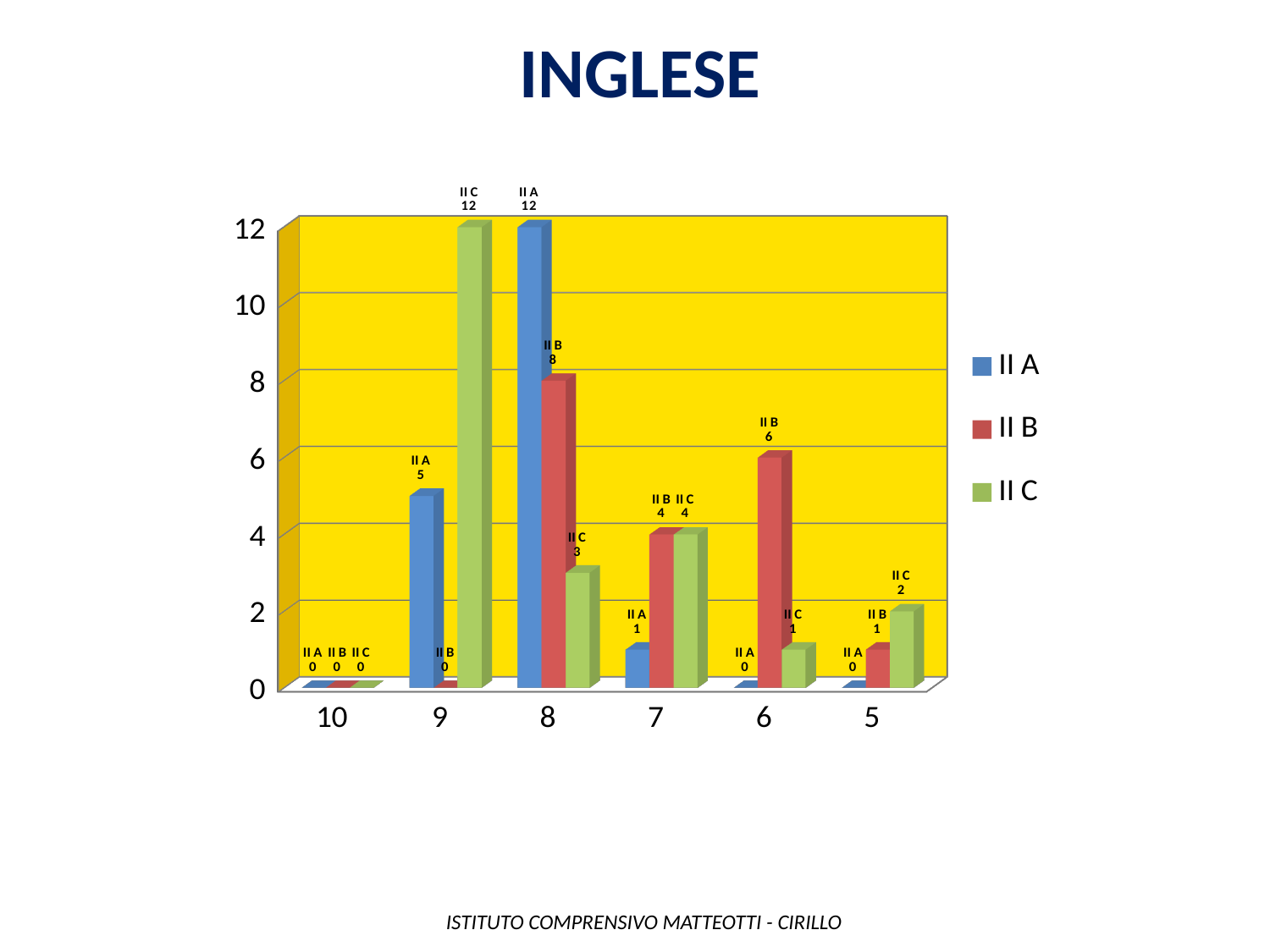
What kind of chart is shown on the slide? Bar chart At which grade does II A have its highest value? 8 What is the value for II B at grade 6? 6 How many grade categories are shown on the x axis? 6 What is the value for II C at grade 9? 12 At which grade does II B have its highest value? 8 How many series does the legend list? 3 Which is larger at grade 9: II A or II C? II C What is the difference between II A and II B at grade 8? 4 What is the value for II A at grade 7? 1 What is the title of the chart? INGLESE What is the value for II B at grade 8? 8